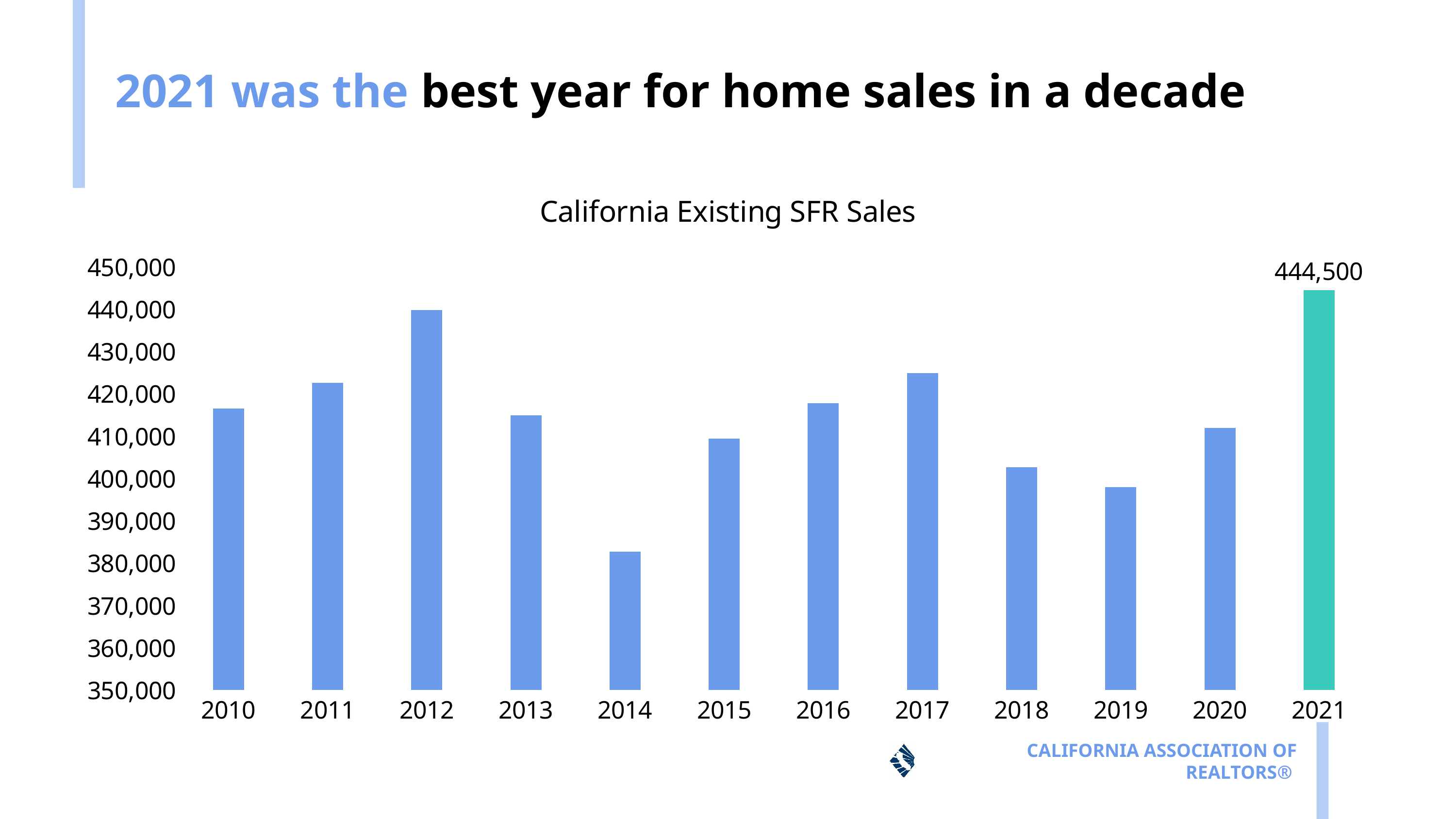
Do sales rise or fall from 2017 to 2019? Fall Is the value for 2014 greater or less than 390,000? less Is the value for 2019 greater or less than 400,000? less Which year has higher sales, 2012 or 2017? 2012 How many years are plotted in the California Existing SFR Sales chart? 12 Which year has higher sales, 2014 or 2018? 2018 Is the value for 2012 greater or less than 430,000? greater Which year has the lowest sales in the California Existing SFR Sales chart? 2014 What is the value shown for 2021 in the California Existing SFR Sales chart? 444,500 Which year has the highest sales in the California Existing SFR Sales chart? 2021 What kind of chart is used to show California Existing SFR Sales? Bar chart Which year's bar is shown in a different colour (green) from the others? 2021